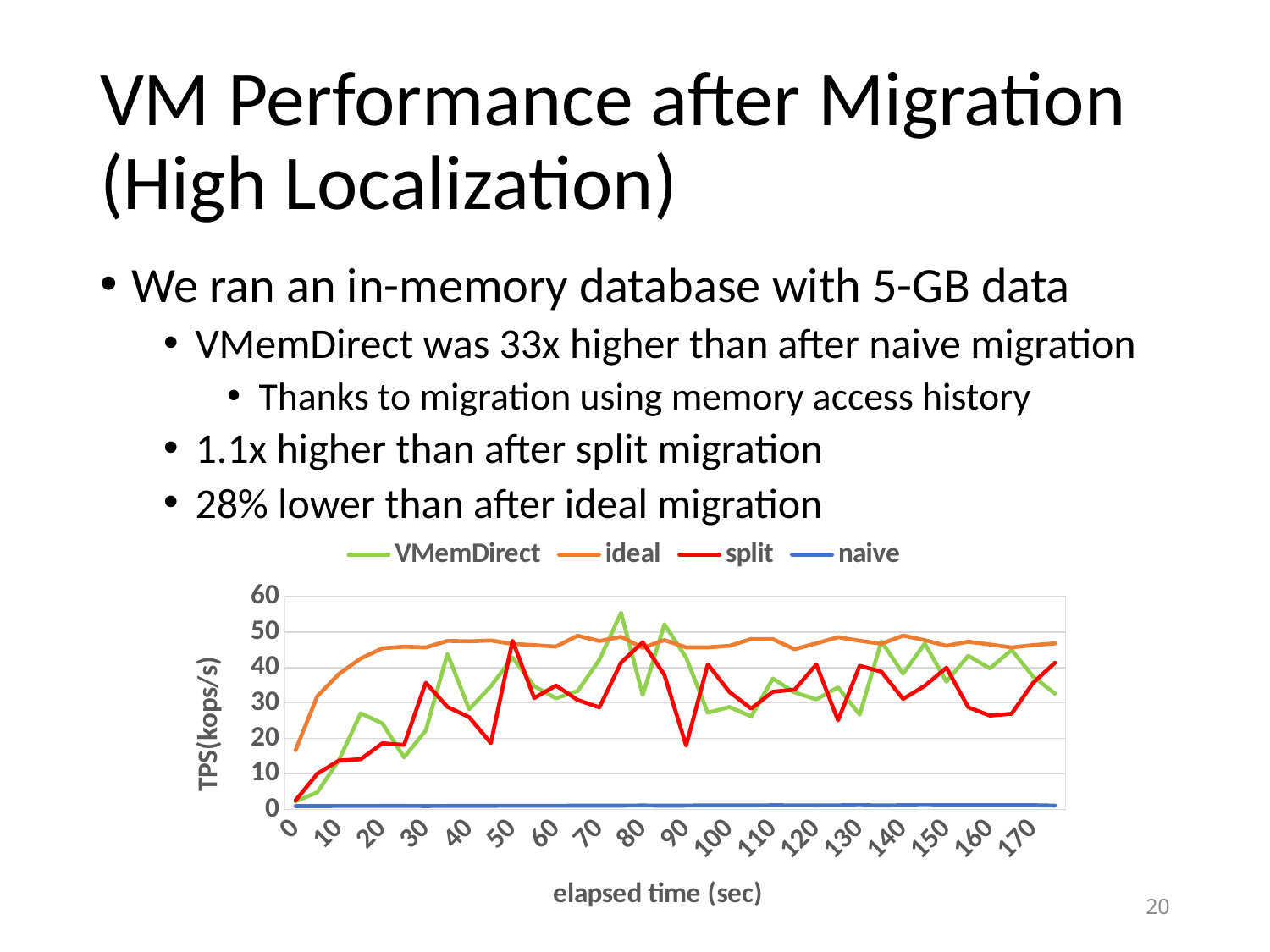
Is the value for ideal at 40 seconds greater or less than 40? greater Which series stays lowest across the whole chart? naive Does the ideal series rise or fall between 0 and 30 seconds? rise At 100 seconds, which is larger, ideal or naive? ideal How many series does the chart's legend list? 4 What is the label of the chart's x axis? elapsed time (sec) Which series is drawn in blue in the chart? naive Is the value for VMemDirect at 0 seconds greater or less than 10? less Is the value for split at 90 seconds greater or less than 30? less What is the label of the chart's y axis? TPS(kops/s) What kind of chart is shown on the slide? line chart